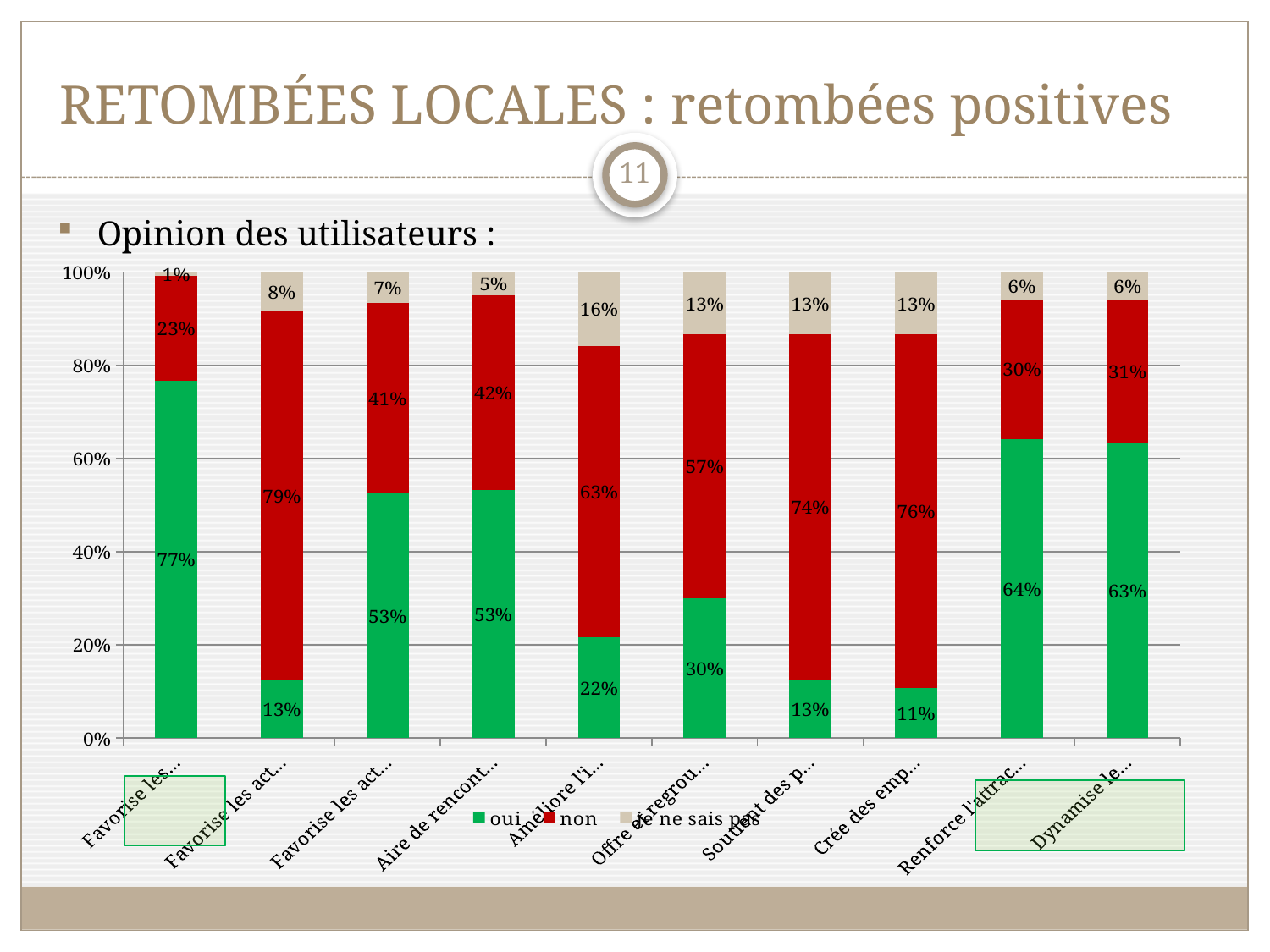
What kind of chart is shown on the slide? stacked bar chart In the first bar from the left, what is the difference between the 'oui' and 'non' values? 54 percentage points What is the 'non' value for the second bar from the left? 79% What is the 'je ne sais pas' value for the fifth bar from the left? 16% What are the three legend entries of the chart? oui, non, je ne sais pas What is the 'oui' value for the first bar from the left? 77% Which has the larger 'oui' value: the fifth bar or the sixth bar from the left? the sixth bar (30%) Which bar has the highest 'oui' share? the first bar from the left (77%) How many series does the legend list? 3 Which bar has the lowest 'oui' share? the eighth bar from the left (11%) How many bars (categories) are plotted in the chart? 10 Is the 'oui' value for the fourth bar from the left greater or less than 40%? greater